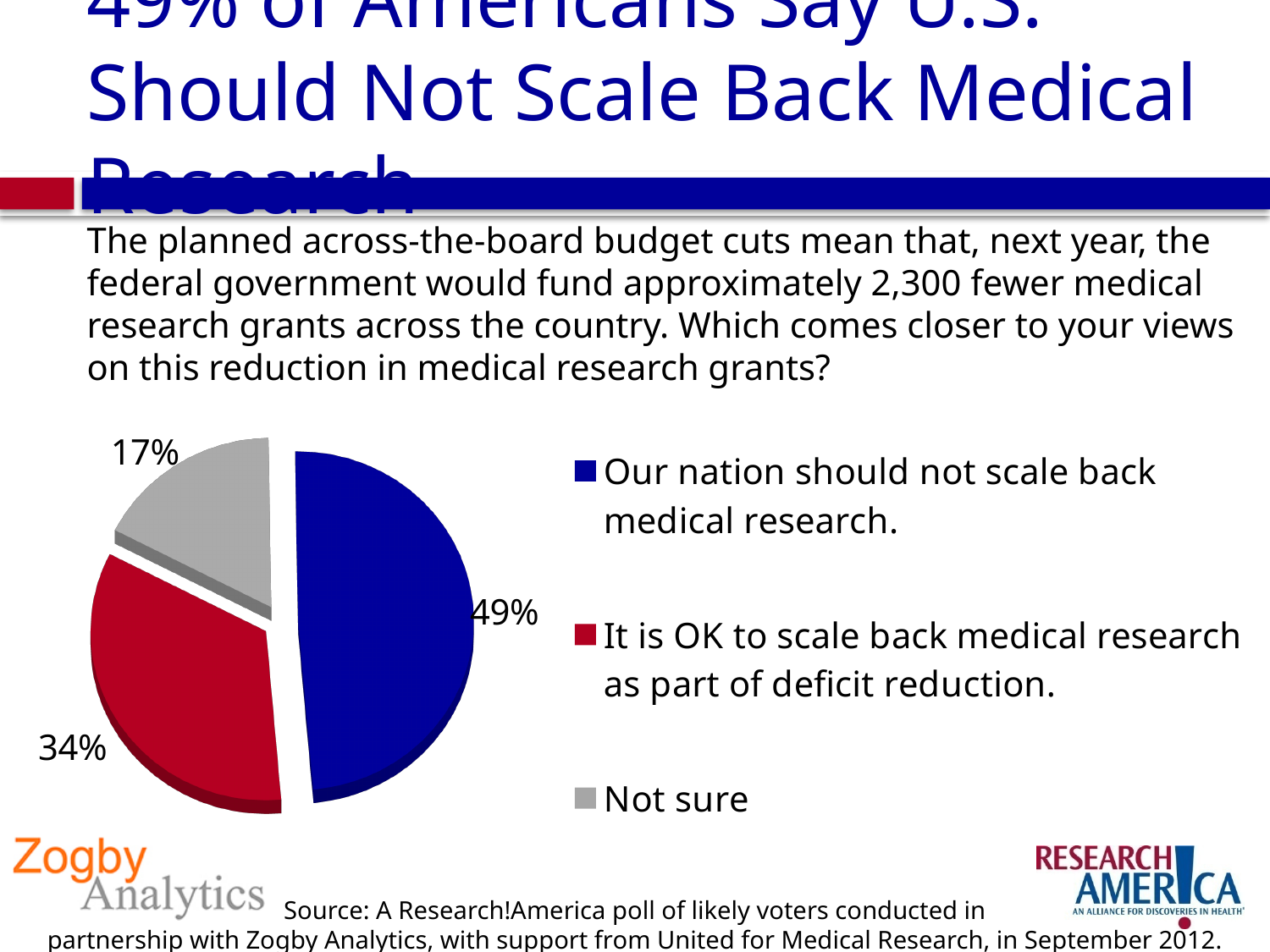
Which is larger: the share saying it is OK to scale back medical research or the share saying not sure? It is OK to scale back medical research as part of deficit reduction. What percentage of respondents said it is OK to scale back medical research as part of deficit reduction? 34% Which response received the largest share of respondents? Our nation should not scale back medical research. How many slices does the pie chart have? 3 What colour is the slice representing 'Not sure'? Gray What is the difference in percentage points between those who said the nation should not scale back medical research and those who said it is OK to scale back? 15 What colour is the slice representing 'Our nation should not scale back medical research'? Blue Which response received the smallest share of respondents? Not sure What type of chart is shown on the slide? Pie chart What is the difference in percentage points between the 'It is OK to scale back' slice and the 'Not sure' slice? 17 What percentage of respondents were not sure? 17% What percentage of respondents said our nation should not scale back medical research? 49%